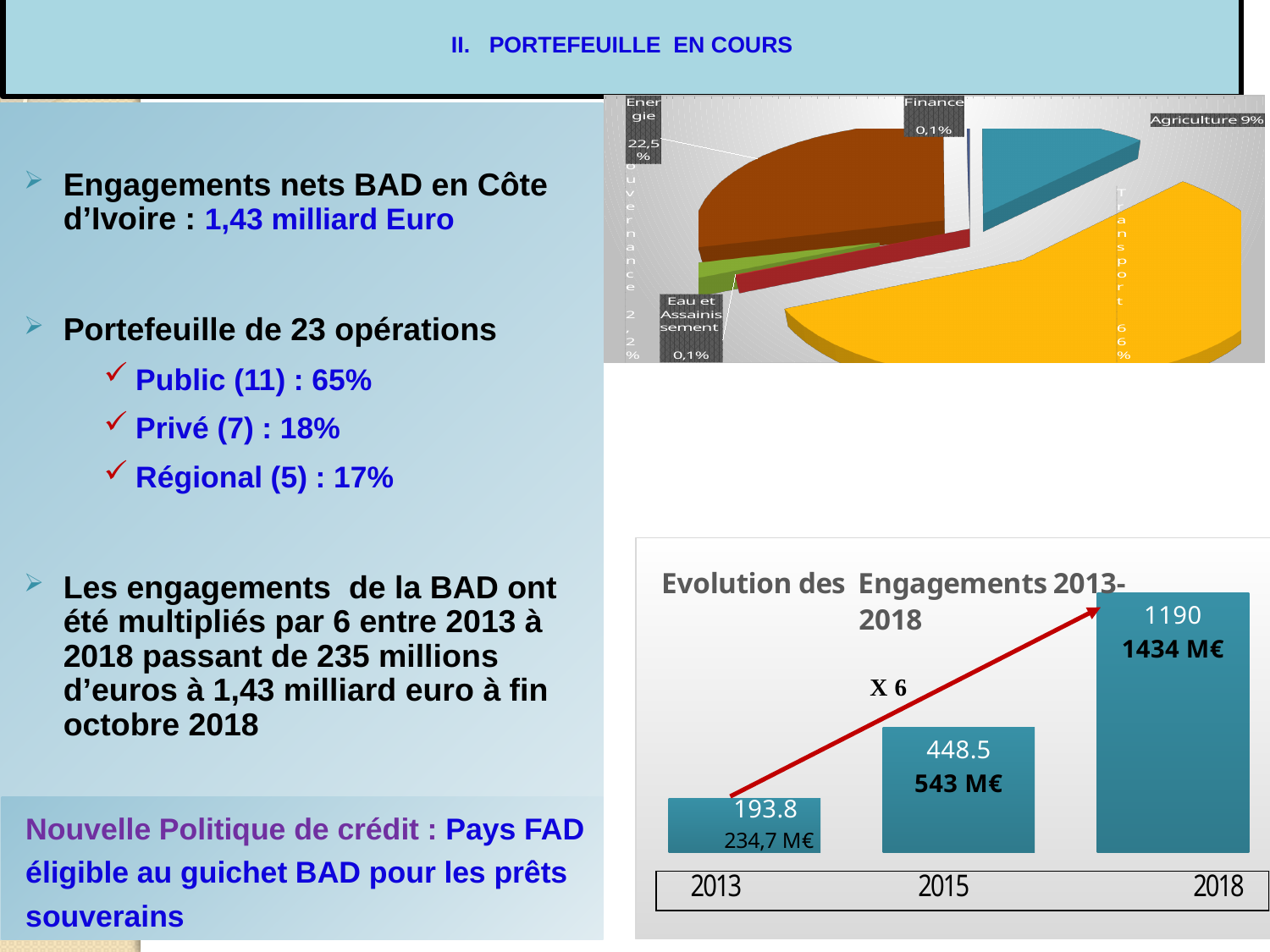
In the bar chart titled 'Evolution des Engagements 2013-2018', which year has the highest bar? 2018 What kind of chart is the one at the bottom right of the slide? bar chart In the bar chart titled 'Evolution des Engagements 2013-2018', how many years are shown on the x axis? 3 In the pie chart at the top right of the slide, what percentage is shown for Agriculture? 9% In the bar chart titled 'Evolution des Engagements 2013-2018', what is the data label shown on the bar for 2015? 448.5 In the bar chart titled 'Evolution des Engagements 2013-2018', what is the data label shown on the bar for 2018? 1190 In the bar chart titled 'Evolution des Engagements 2013-2018', do the values rise or fall from 2013 to 2018? rise In the bar chart titled 'Evolution des Engagements 2013-2018', what is the data label shown on the bar for 2013? 193.8 In the bar chart titled 'Evolution des Engagements 2013-2018', which year has the lowest bar? 2013 In the pie chart at the top right of the slide, what percentage is shown for Energie? 22,5% In the bar chart titled 'Evolution des Engagements 2013-2018', what is the difference between the data labels for 2018 and 2015? 741.5 In the pie chart at the top right of the slide, which sector has the largest slice? Transport